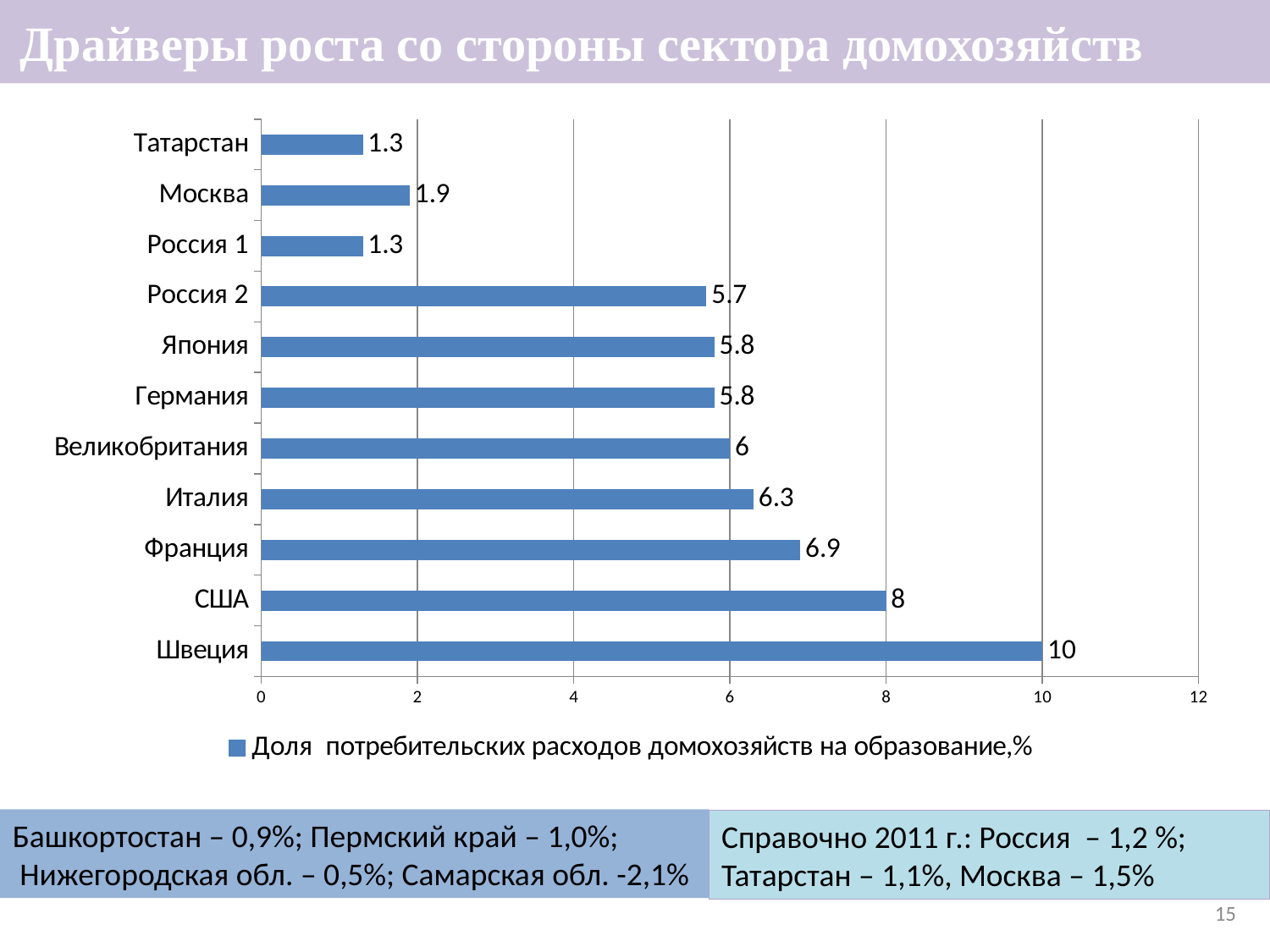
What is the difference between the values for США and Италия? 1.7 What is the legend entry of the chart? Доля потребительских расходов домохозяйств на образование,% What is the value for Франция? 6.9 How many series does the legend list? 1 Which is larger, the value for Япония or the value for Великобритания? Великобритания What is the value for Москва? 1.9 Which category has the highest value? Швеция How many categories are shown in the chart? 11 What kind of chart is shown on the slide? bar chart What is the difference between the values for Швеция and Татарстан? 8.7 Is the value for Россия 2 greater or less than 4? greater What is the value for Швеция? 10